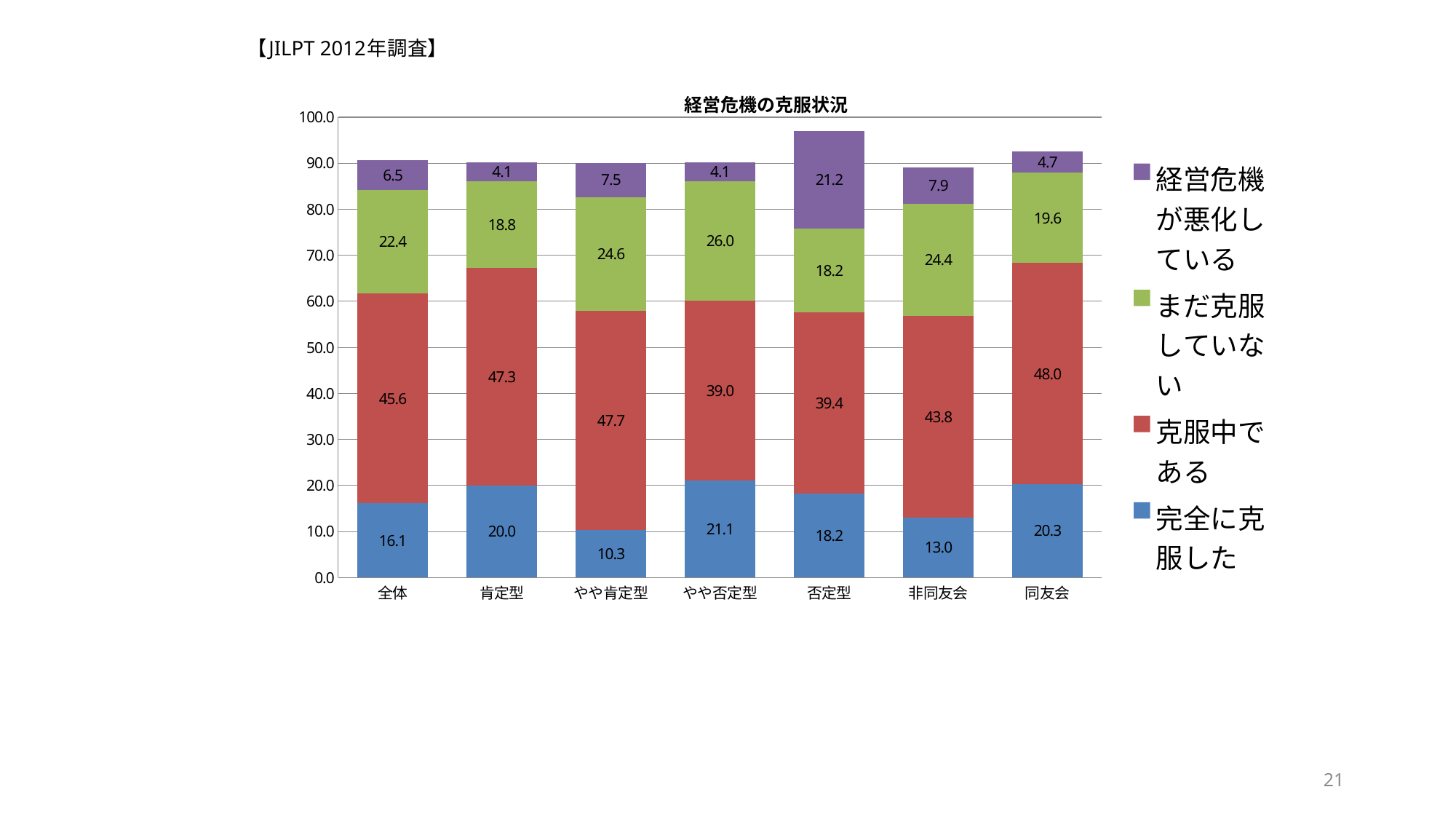
What is the difference between the 完全に克服した values for 同友会 and 非同友会? 7.3 What is the total of the stacked bar for 否定型? 97.0 Which category has the lowest value for 完全に克服した? やや肯定型 What is the value of 克服中である for 同友会? 48.0 What is the value of 完全に克服した for やや否定型? 21.1 How many series does the legend list? 4 Which category has the highest value for 経営危機が悪化している? 否定型 How many categories are shown on the x axis? 7 What is the title of the chart? 経営危機の克服状況 What type of chart is shown on the slide? Stacked bar chart Which is larger, the まだ克服していない value for やや否定型 or for 肯定型? やや否定型 What is the value of 経営危機が悪化している for 否定型? 21.2